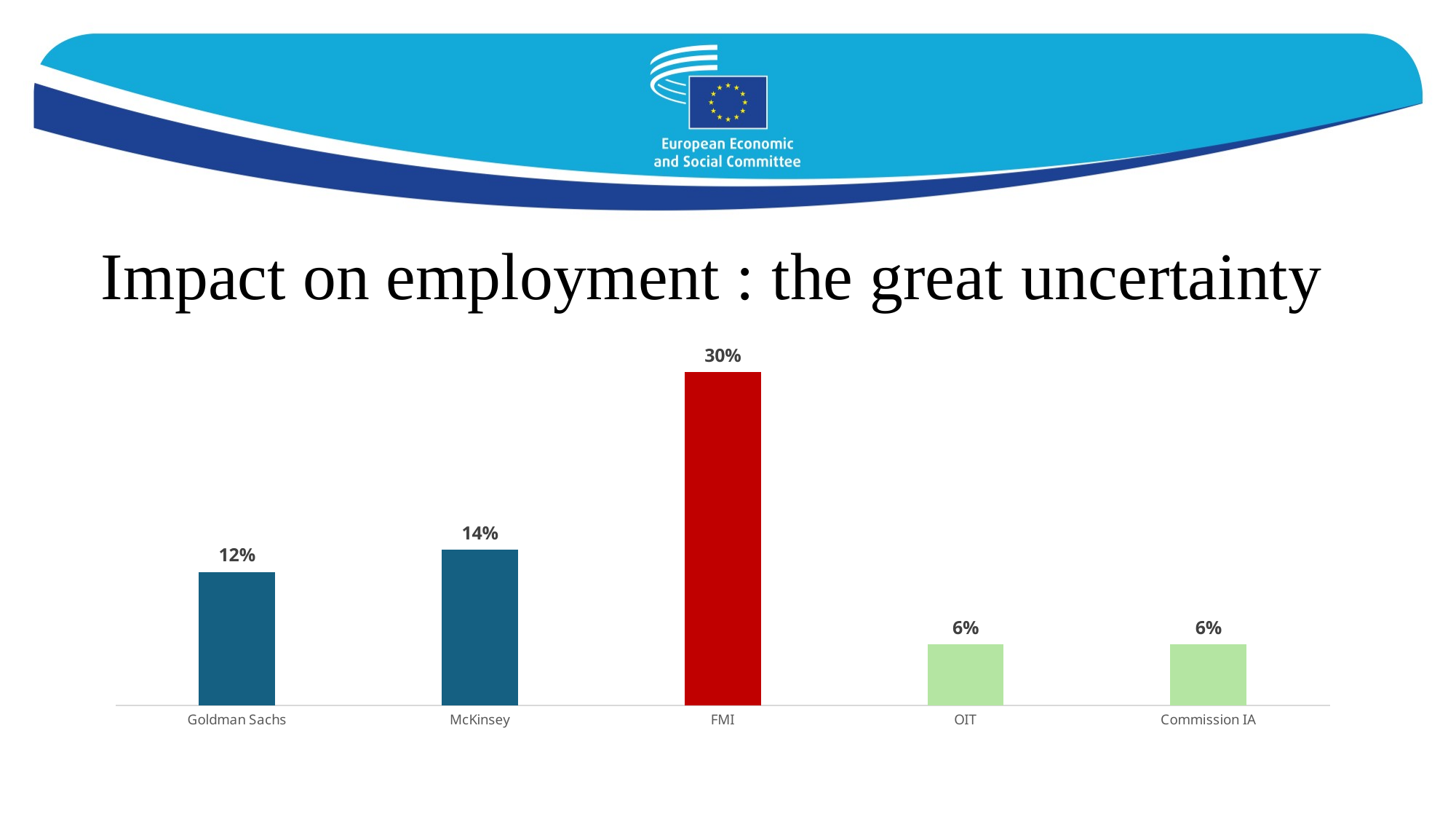
What is the difference between the values for FMI and McKinsey? 16% What is the value for FMI? 30% Which is larger, the value for Goldman Sachs or the value for OIT? Goldman Sachs Which category has the highest value? FMI What is the difference between the values for McKinsey and Goldman Sachs? 2% What is the value for McKinsey? 14% What kind of chart is shown on the slide? Bar chart What colour is the bar for FMI? Red How many categories are shown in the chart? 5 What is the value for Goldman Sachs? 12% What is the value for OIT? 6% What is the value for Commission IA? 6%